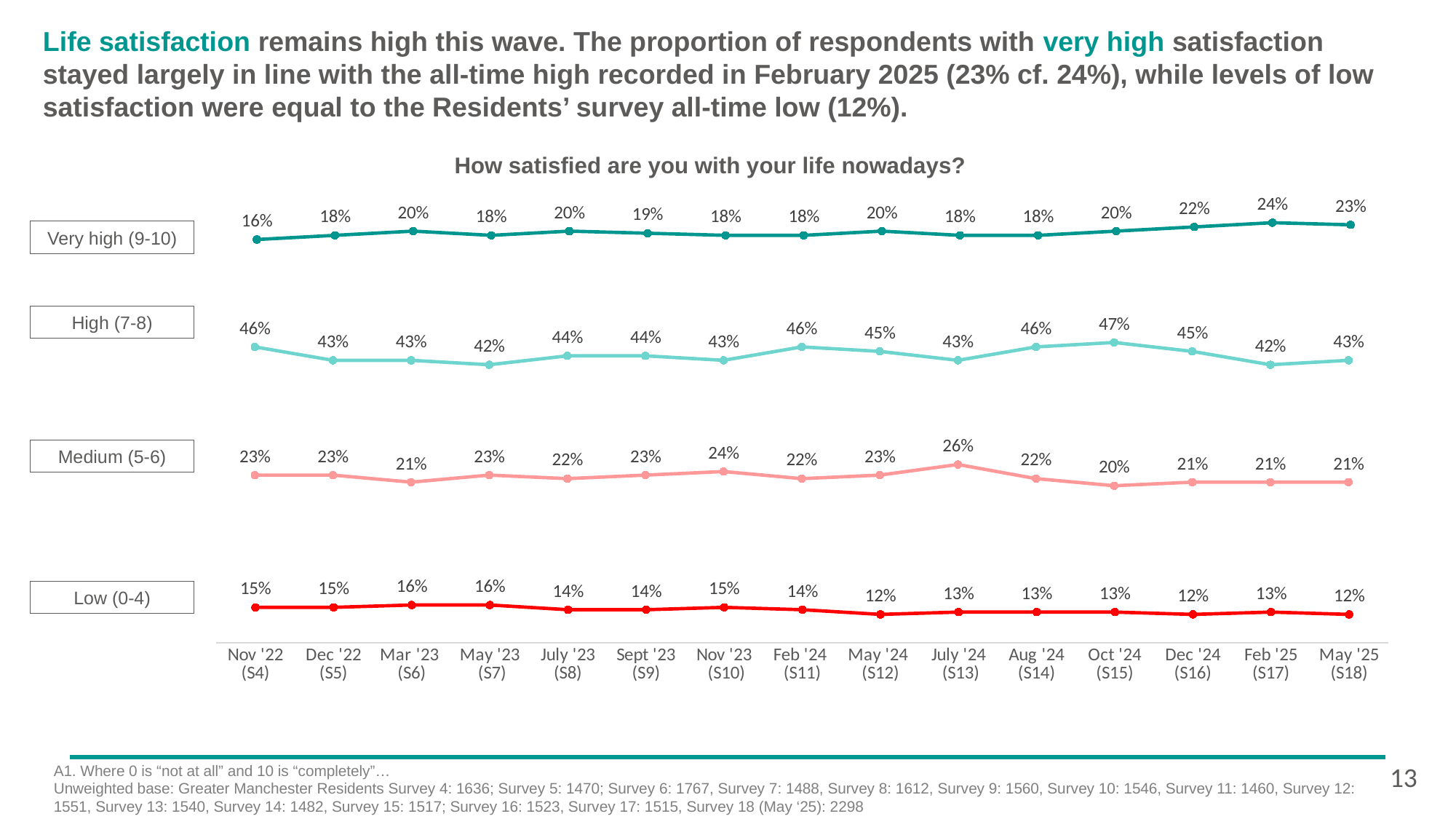
What is the value for High (7-8) in Oct '24 (S15)? 47% In which survey wave does the Very high (9-10) series reach its highest value? Feb '25 (S17) What is the value for Low (0-4) in Nov '23 (S10)? 15% What is the difference between the Very high (9-10) value in Feb '25 (S17) and in Nov '22 (S4)? 8 percentage points How many series are shown in the chart? 4 In which survey wave does the Medium (5-6) series reach its highest value? July '24 (S13) Does the Low (0-4) series rise or fall from Nov '22 (S4) to May '25 (S18)? Fall In which survey wave is the Very high (9-10) series at its lowest value? Nov '22 (S4) What is the value for Very high (9-10) in May '25 (S18)? 23% In May '25 (S18), which is larger: High (7-8) or Medium (5-6)? High (7-8) How many survey waves are plotted on the x axis? 15 What kind of chart is shown on the slide? Line chart